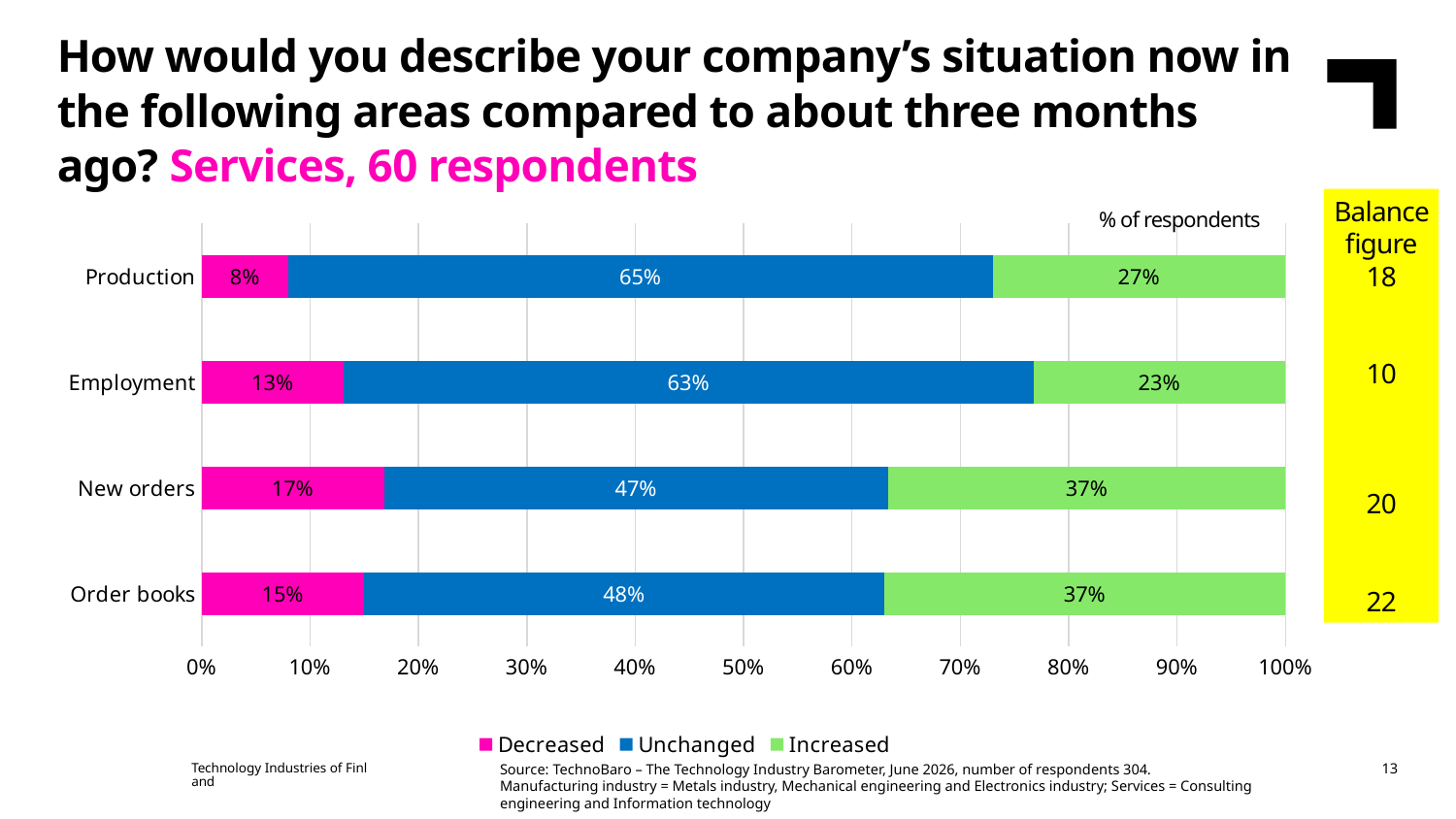
How many series does the legend list? 3 Which colour represents the Decreased series in the legend? Pink (magenta) Which category has the highest Unchanged share? Production What is the Increased value for New orders? 37% What percentage of respondents reported that Production was unchanged? 65% What kind of chart is shown on the slide? Stacked bar chart Is the Increased share larger for Production or for Employment? Production Which category has the lowest Decreased share? Production What is the difference between the Unchanged values for Employment and Order books? 15 percentage points What is the Decreased value for Employment? 13% How many categories are shown on the chart? 4 What is the balance figure shown for Order books? 22